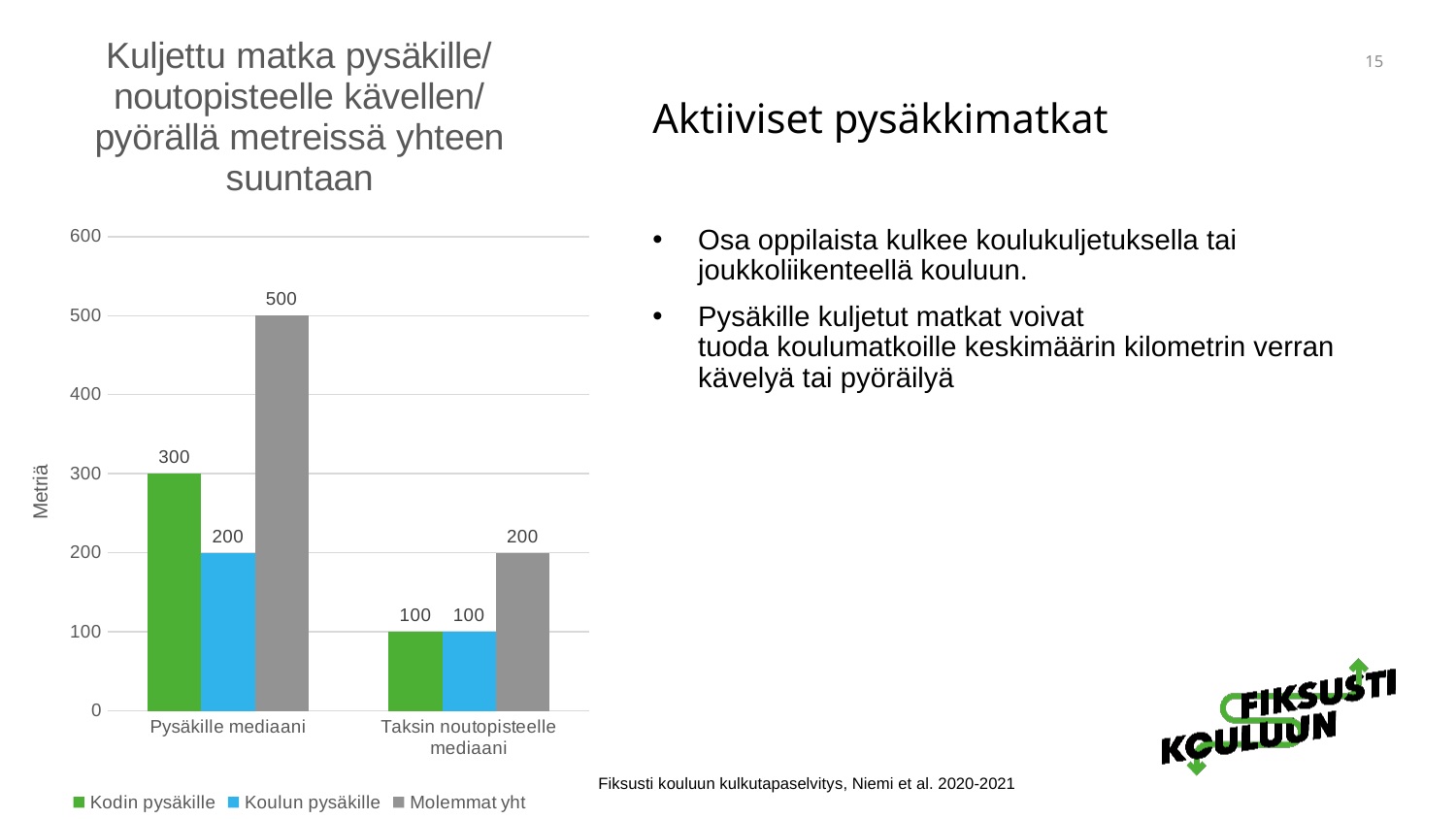
What kind of chart is shown on the slide? Bar chart Which series has the lowest value in the Pysäkille mediaani category? Koulun pysäkille Which is larger: Kodin pysäkille for Pysäkille mediaani or Kodin pysäkille for Taksin noutopisteelle mediaani? Pysäkille mediaani What is the value for Kodin pysäkille in the Pysäkille mediaani category? 300 What is the value for Koulun pysäkille in the Taksin noutopisteelle mediaani category? 100 How many categories are shown on the x axis? 2 What is the label of the y axis? Metriä What is the value for Molemmat yht in the Pysäkille mediaani category? 500 How many series does the legend list? 3 What is the value for Molemmat yht in the Taksin noutopisteelle mediaani category? 200 Which series has the highest value in the Pysäkille mediaani category? Molemmat yht What is the difference between Molemmat yht for Pysäkille mediaani and Molemmat yht for Taksin noutopisteelle mediaani? 300